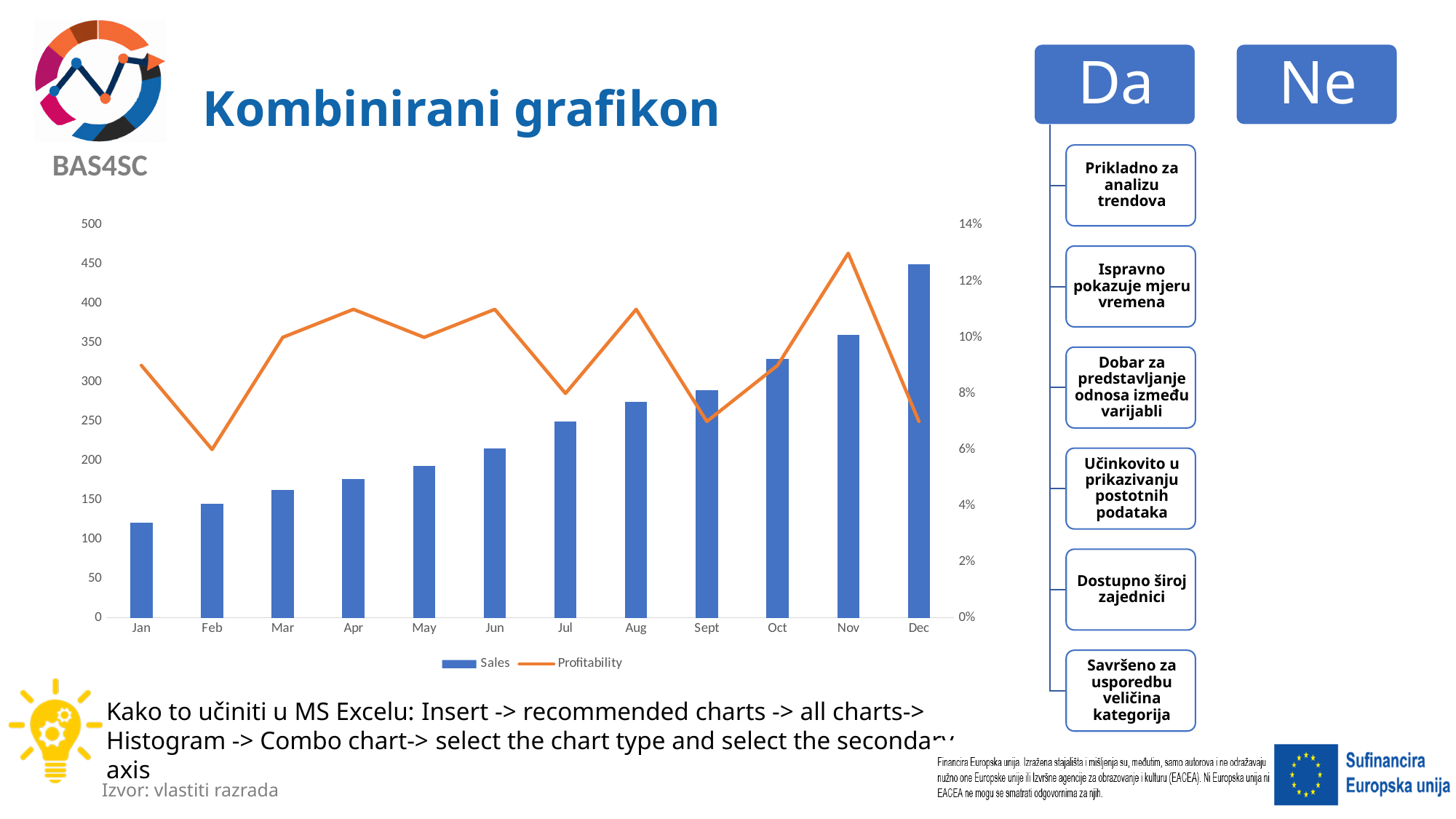
What are the two series named in the chart legend? Sales and Profitability How many months are shown on the x axis of the chart? 12 In which month does the Profitability line reach its lowest point? Feb Which month has the lowest Sales bar? Jan How many series does the chart legend list? 2 Which month has the larger Sales value, Sept or Oct? Oct Do the Sales bars generally rise or fall from Jan to Dec? rise Is the Sales value for Jan greater or less than 150? less Which month has the highest Sales bar? Dec What kind of chart is shown on the slide? A combination bar and line chart Is the Sales value for Dec greater or less than 400? greater In which month does the Profitability line reach its highest point? Nov